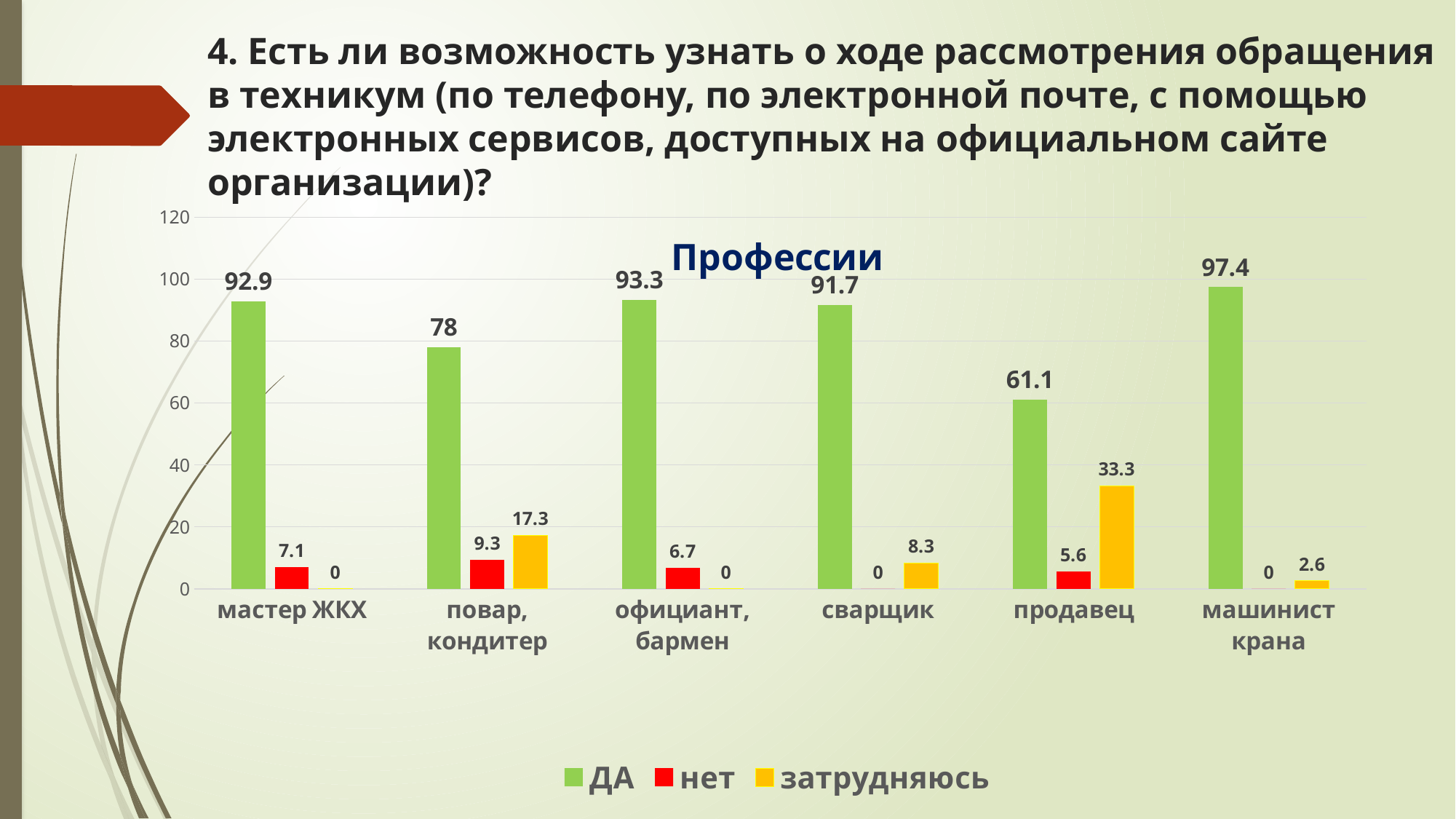
What is the value of the ДА series for машинист крана? 97.4 What is the value of the затрудняюсь series for продавец? 33.3 What is the value of the нет series for повар, кондитер? 9.3 What kind of chart is shown on the slide? bar chart How many categories are shown on the x axis? 6 Which category has the highest value in the ДА series? машинист крана Which is larger: the затрудняюсь value for повар, кондитер or for сварщик? повар, кондитер What is the title of the chart? Профессии Which category has the lowest value in the ДА series? продавец Is the ДА value for повар, кондитер greater or less than 80? less What is the difference between the ДА values for машинист крана and продавец? 36.3 How many series does the legend list? 3